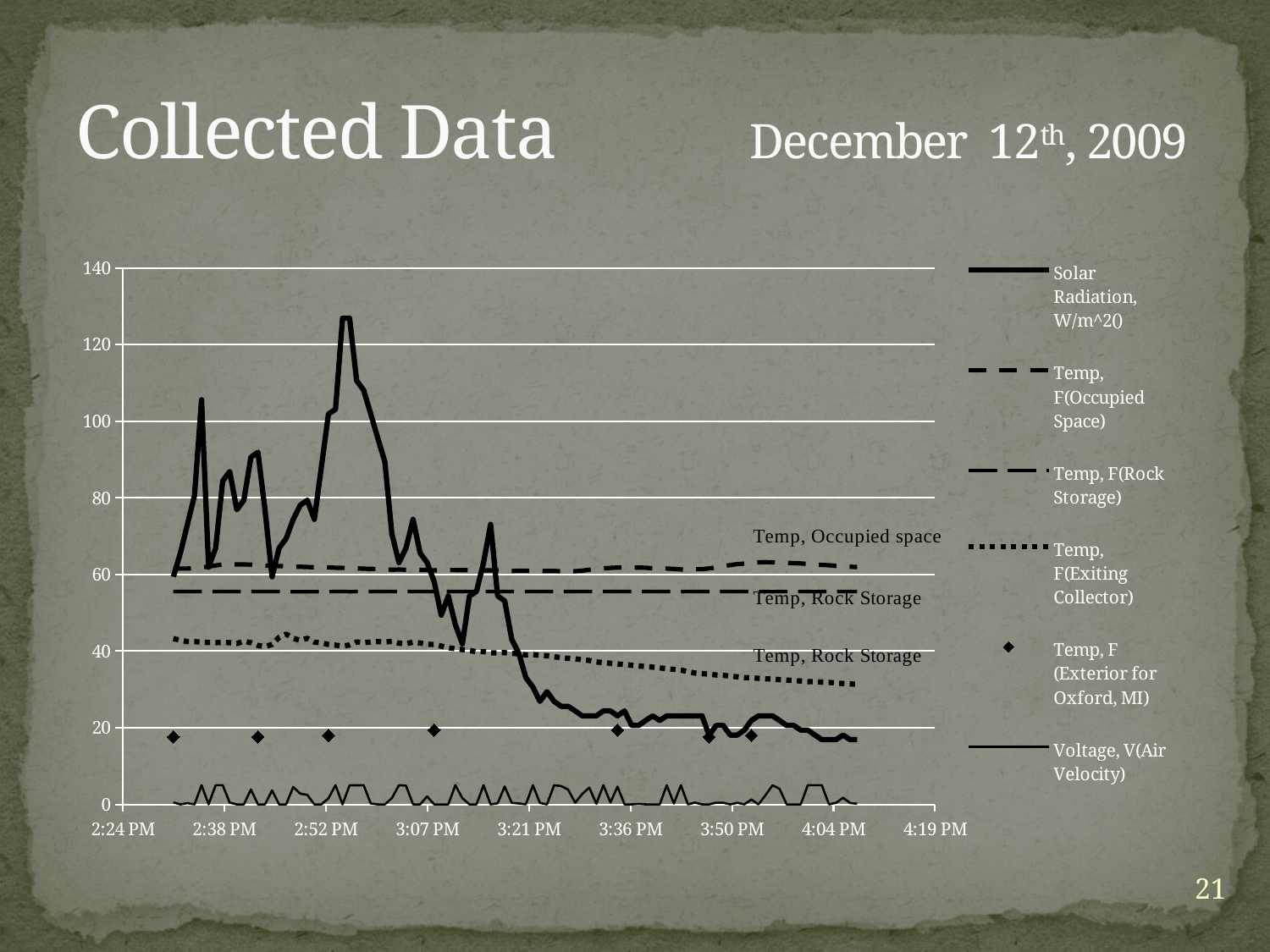
Does the Temp, F(Exiting Collector) series rise or fall from 3:07 PM to 4:04 PM? fall Is the value of the Temp, F(Exiting Collector) series at 4:04 PM greater or less than 40? less Is the peak value of the Solar Radiation series greater or less than 120? greater How many series does the chart legend list? 6 Is the value of the Temp, F (Exterior for Oxford, MI) series at 3:07 PM greater or less than 40? less What kind of chart is shown on the slide? line chart Which series is higher at 3:50 PM: Temp, F(Exiting Collector) or Temp, F (Exterior for Oxford, MI)? Temp, F(Exiting Collector) Does the Solar Radiation series rise or fall overall from 3:07 PM to 4:04 PM? fall Which series is higher throughout the chart: Temp, F(Occupied Space) or Temp, F(Rock Storage)? Temp, F(Occupied Space) What is the highest value shown on the chart's vertical axis? 140